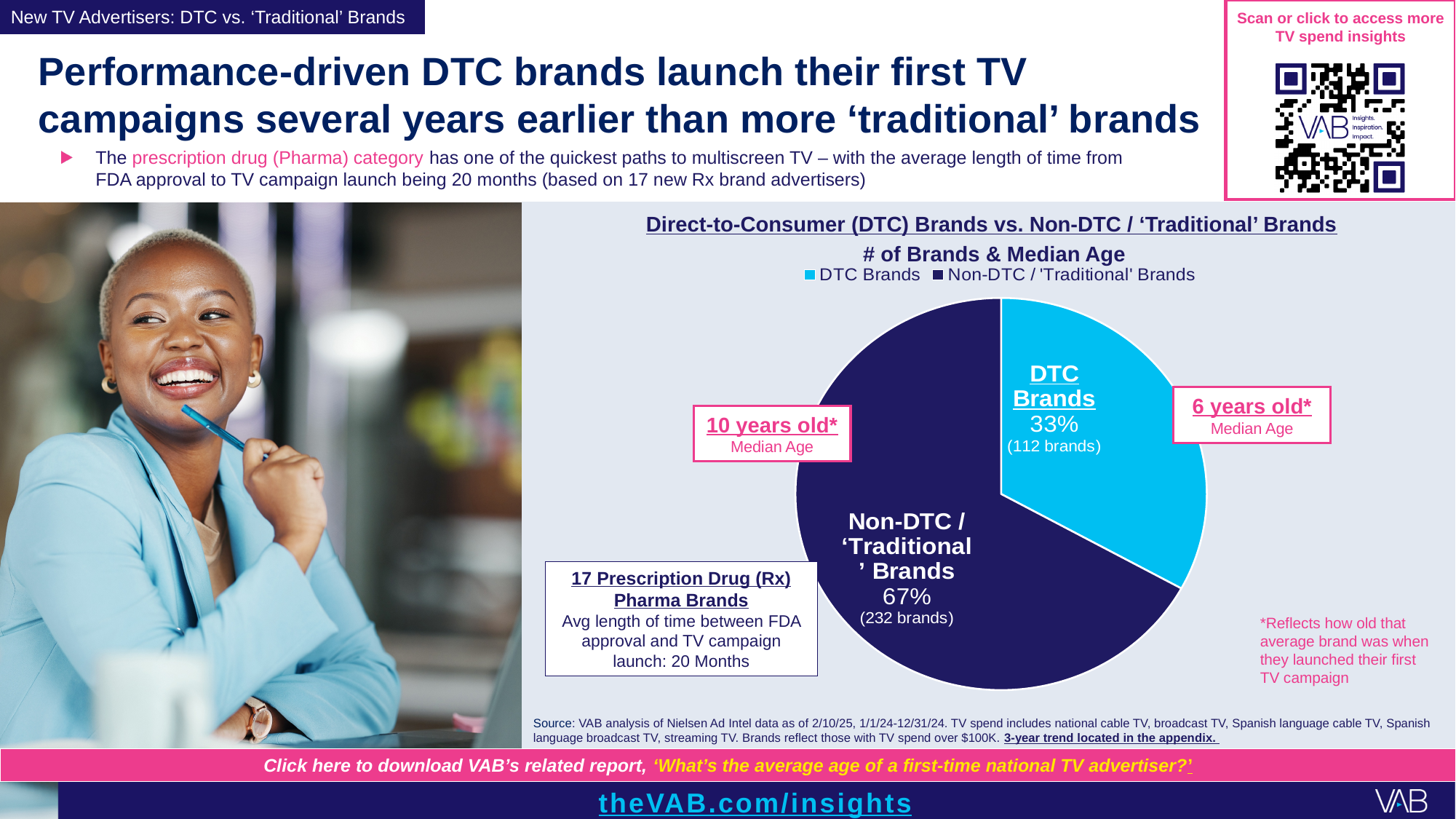
Which slice is larger, DTC Brands or Non-DTC / 'Traditional' Brands? Non-DTC / 'Traditional' Brands What is the median age shown for Non-DTC / 'Traditional' Brands? 10 years old What share of the pie do DTC Brands represent? 33% What kind of chart is shown on the slide? Pie chart How many brands are in the DTC Brands slice? 112 brands How many slices does the pie chart have? 2 What share of the pie do Non-DTC / 'Traditional' Brands represent? 67% How many brands are in the Non-DTC / 'Traditional' Brands slice? 232 brands How many entries does the chart legend list? 2 What is the difference in number of brands between Non-DTC / 'Traditional' Brands and DTC Brands? 120 brands What is the median age shown for DTC Brands? 6 years old Which category has the smallest slice of the pie? DTC Brands